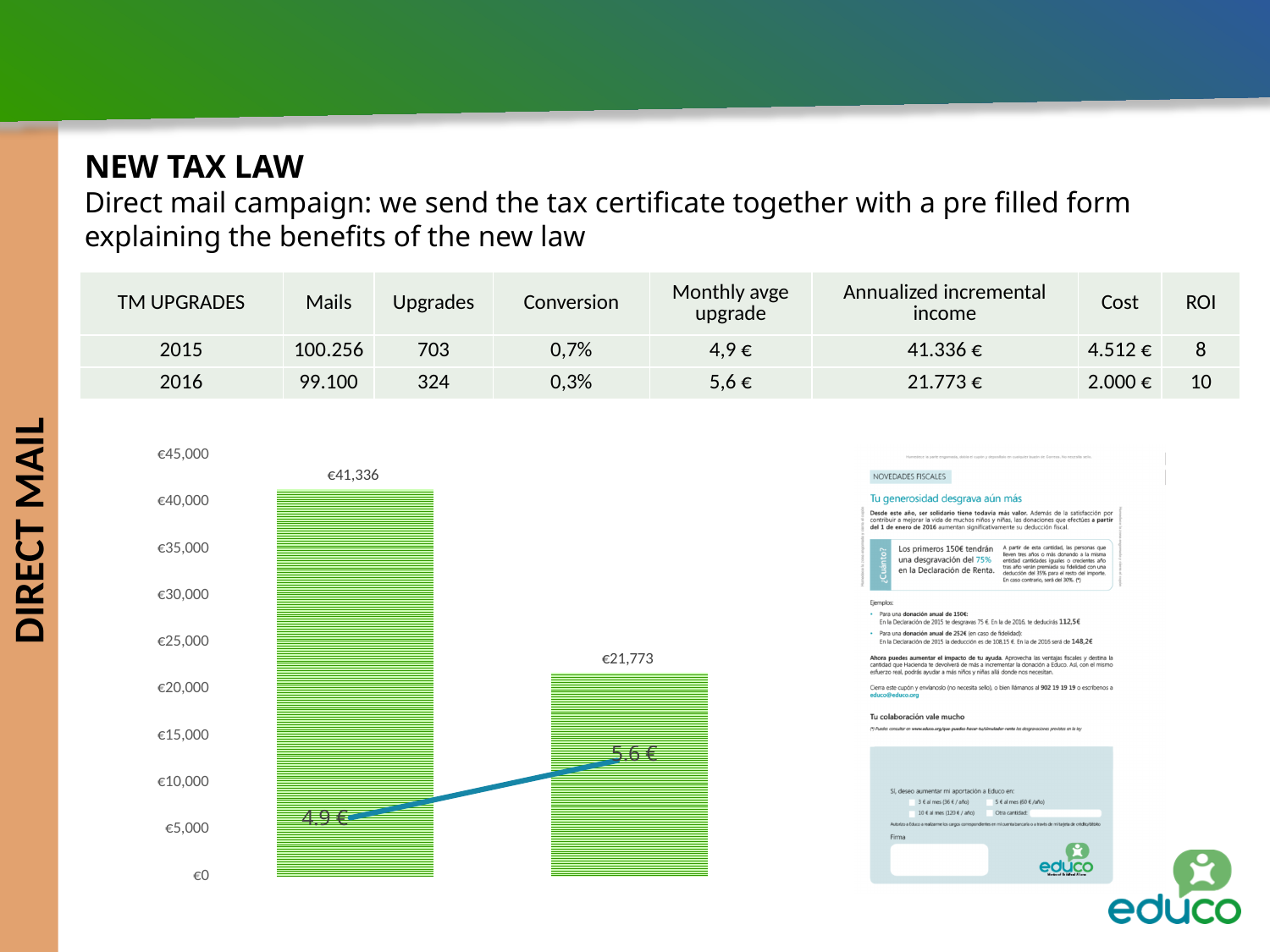
Does the line drawn across the chart rise or fall from left to right? rises What is the highest value shown on the chart's vertical axis? €45,000 Which bar in the chart is the highest, the left one or the right one? the left one What kind of chart is shown on the slide? bar chart How many bars are plotted in the chart? 2 Is the value of the left bar greater or less than €40,000? greater What value is labelled at the right end of the line drawn across the chart? 5.6 € Is the value of the right bar greater or less than €25,000? less What is the value labelled on the right (shorter) bar of the chart? €21,773 What value is labelled at the left end of the line drawn across the chart? 4.9 € What is the difference between the two bar values in the chart, €41,336 and €21,773? €19,563 What is the value labelled on the left (taller) bar of the chart? €41,336